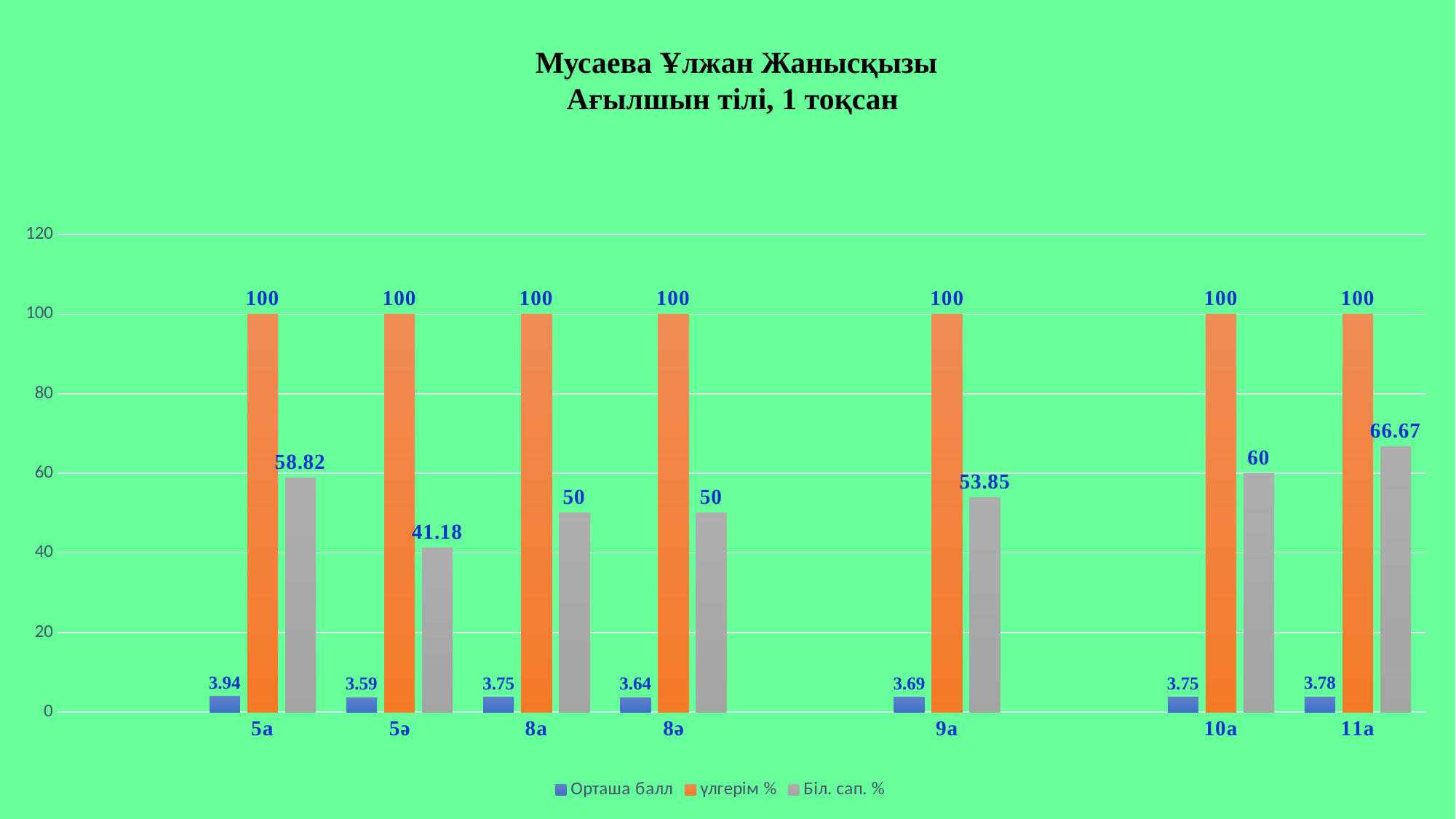
What kind of chart is shown on the slide? bar chart What is the Орташа балл value for 5ә? 3.59 How many series does the legend list? 3 Which category has the highest Біл. сап. % value? 11а How many categories are shown on the x axis? 7 Is the Біл. сап. % value for 9а greater or less than 40? greater What colour are the үлгерім % bars? orange What is the Біл. сап. % value for 11а? 66.67 What is the difference between the Біл. сап. % values for 10а and 5ә? 18.82 What is the үлгерім % value for 9а? 100 Which is larger, the Орташа балл value for 5а or for 8ә? 5а Which category has the lowest Орташа балл value? 5ә